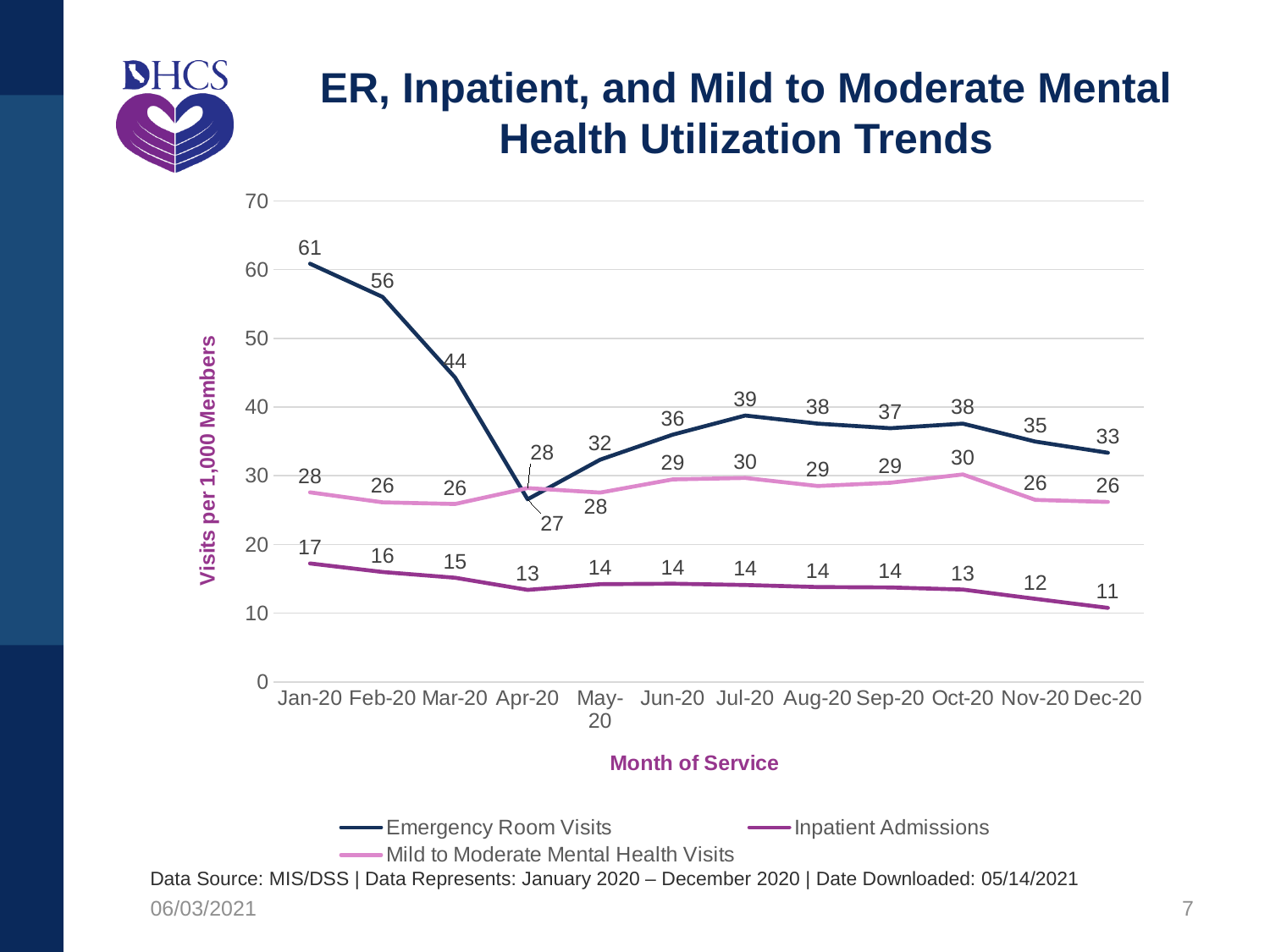
Which is larger in Apr-20: Emergency Room Visits or Mild to Moderate Mental Health Visits? Mild to Moderate Mental Health Visits Do Inpatient Admissions generally rise or fall from Jan-20 to Dec-20? fall What is the difference between Emergency Room Visits in Jan-20 and Feb-20? 5 What is the value of Mild to Moderate Mental Health Visits in Jul-20? 30 What is the label of the y axis? Visits per 1,000 Members In which month are Emergency Room Visits lowest? Apr-20 What is the value of Emergency Room Visits in Jan-20? 61 What is the value of Inpatient Admissions in Dec-20? 11 How many months are plotted along the x axis? 12 In which month are Inpatient Admissions highest? Jan-20 What type of chart is shown on the slide? line chart How many series does the legend list? 3